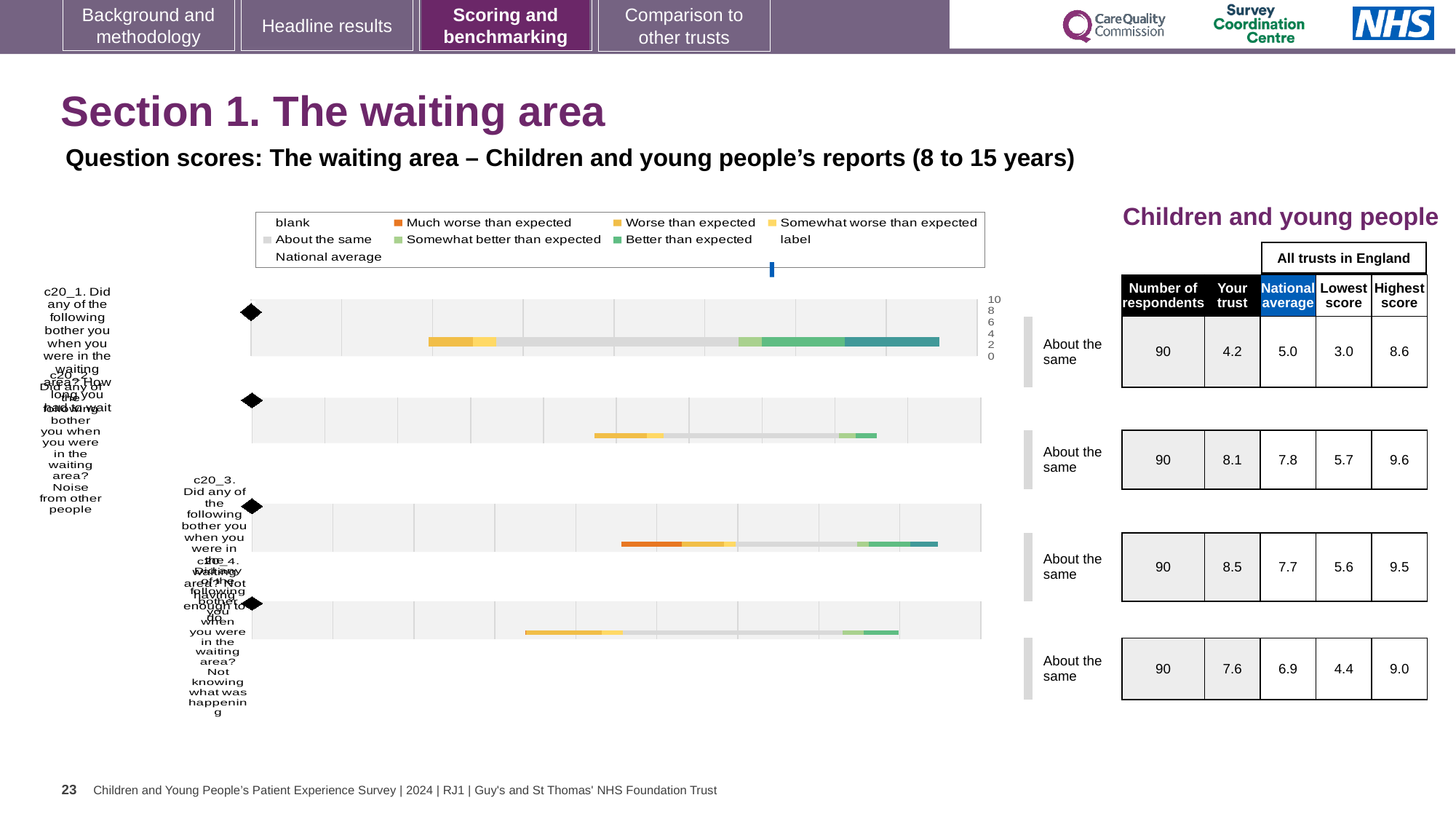
Which legend entry is shown in orange? Much worse than expected What is the difference between the highest and lowest 'Your trust' scores in the table? 4.3 What is the subtitle above the chart? Question scores: The waiting area – Children and young people’s reports (8 to 15 years) Which question has the highest 'Your trust' score in the table? c20_3 Which question has the lowest 'Your trust' score in the table? c20_1 What is the national average for the second question (c20_2) in the table beside the chart? 7.8 What kind of chart is shown on the slide? bar chart How many respondents are listed for the fourth question (c20_4)? 90 How many entries does the chart legend list? 9 How many question bars are plotted in the chart? 4 What is the 'Your trust' score for the first question (c20_1) in the table beside the chart? 4.2 What is the highest score across all trusts in England for the third question (c20_3)? 9.5